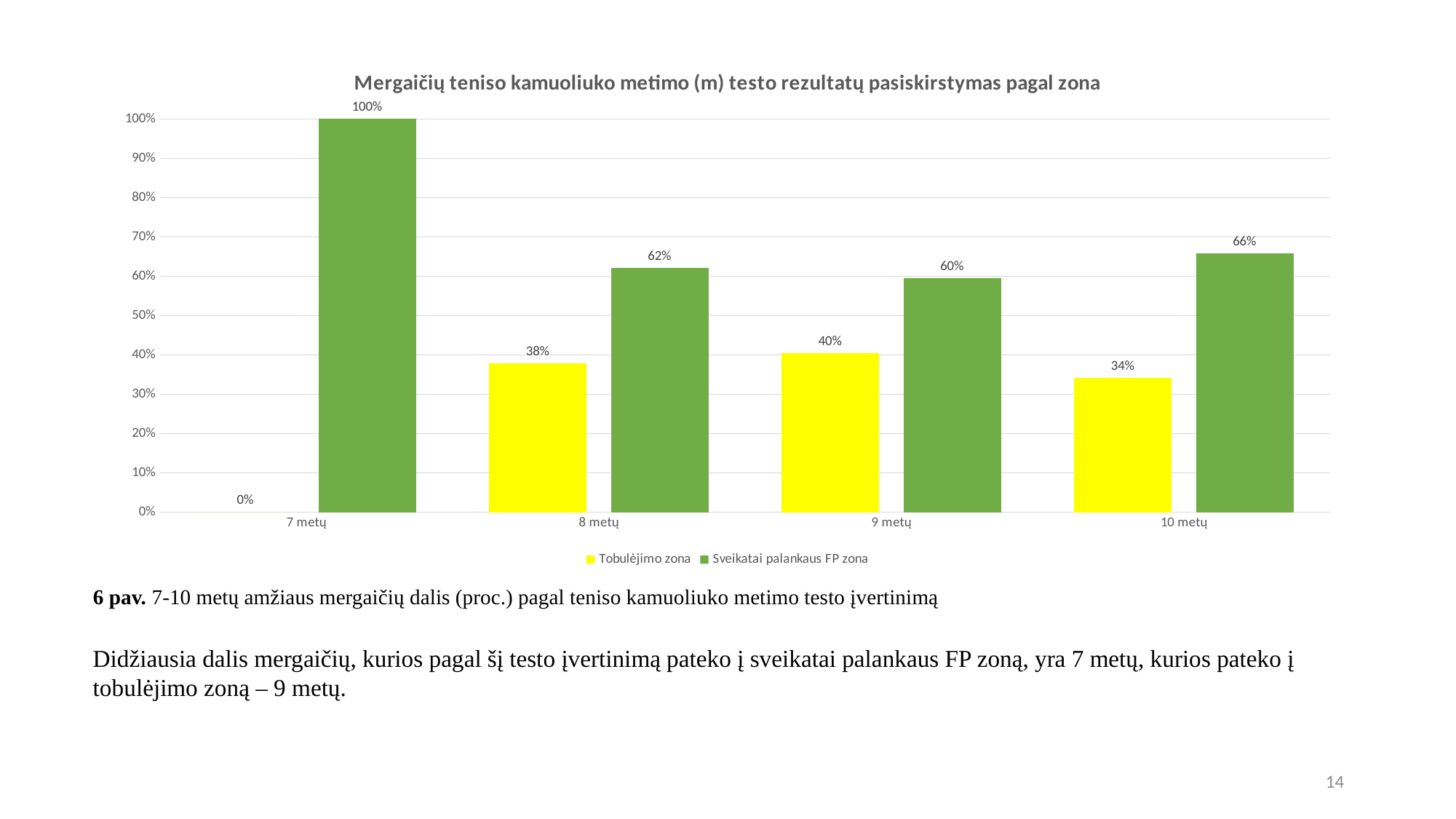
What is the value for Tobulėjimo zona at 9 metų? 40% Which is larger at 9 metų: Tobulėjimo zona or Sveikatai palankaus FP zona? Sveikatai palankaus FP zona What is the difference between Sveikatai palankaus FP zona and Tobulėjimo zona at 8 metų? 24% Which age group has the lowest value for Tobulėjimo zona? 7 metų Which age group has the highest value for Sveikatai palankaus FP zona? 7 metų What is the value for Tobulėjimo zona at 8 metų? 38% How many series does the legend list? 2 What is the value for Sveikatai palankaus FP zona at 7 metų? 100% What is the value for Sveikatai palankaus FP zona at 10 metų? 66% How many age groups are shown on the x axis? 4 Is the value for Sveikatai palankaus FP zona at 9 metų greater or less than 50%? greater What kind of chart is shown on the slide? Bar chart